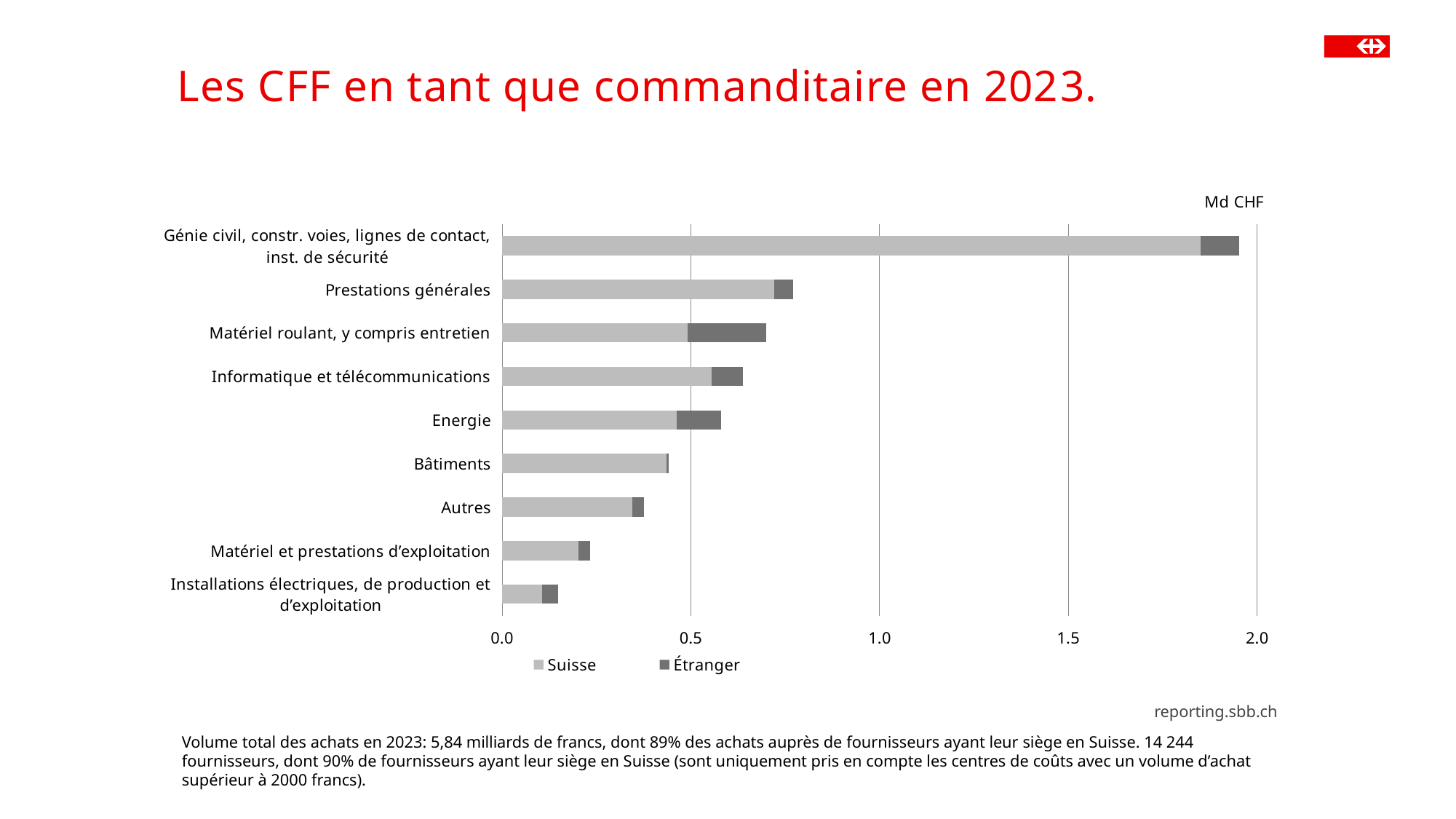
Which has the larger total bar, Energie or Bâtiments? Energie Is the total value for Bâtiments greater or less than 0.5? less Is the total value for Prestations générales greater or less than 0.5? greater What kind of chart is shown on the slide? Bar chart How many series does the legend list? 2 Which category has the longest bar? Génie civil, constr. voies, lignes de contact, inst. de sécurité Is the total value for Génie civil, constr. voies, lignes de contact, inst. de sécurité greater or less than 1.5? greater Which category has the shortest bar? Installations électriques, de production et d'exploitation What are the two series named in the legend? Suisse and Étranger What unit is indicated above the chart? Md CHF How many categories are plotted on the chart? 9